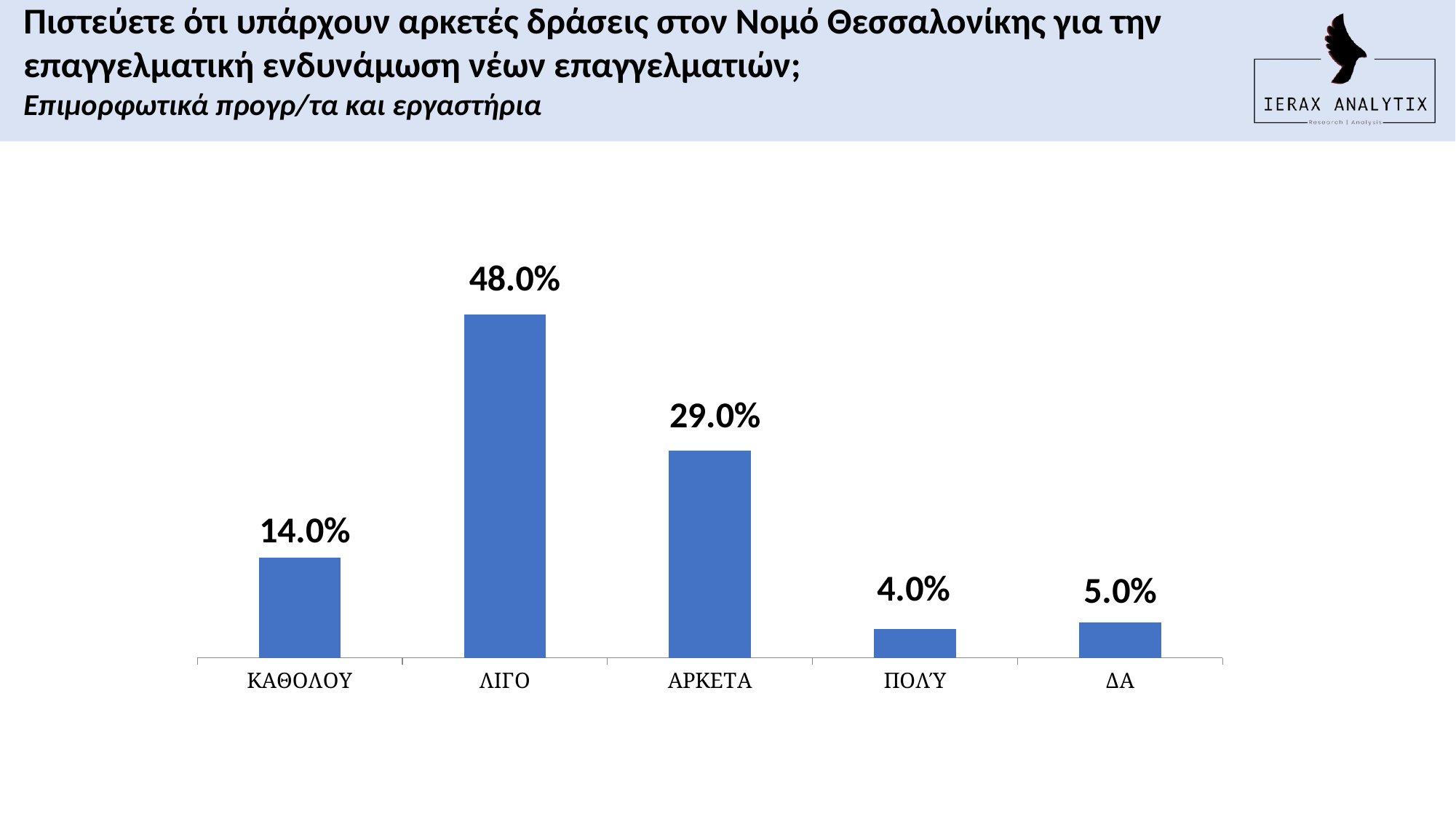
What colour are the bars in the chart? blue How many categories are shown on the x axis? 5 What is the difference between the values for ΛΙΓΟ and ΑΡΚΕΤΑ? 19.0% What is the value for ΚΑΘΟΛΟΥ? 14.0% What is the value for ΛΙΓΟ? 48.0% What kind of chart is shown on the slide? bar chart Which is larger, the value for ΚΑΘΟΛΟΥ or the value for ΔΑ? ΚΑΘΟΛΟΥ Which category has the lowest value? ΠΟΛΎ What is the value for ΑΡΚΕΤΑ? 29.0% Which category has the highest value? ΛΙΓΟ What is the value for ΠΟΛΎ? 4.0% What is the value for ΔΑ? 5.0%